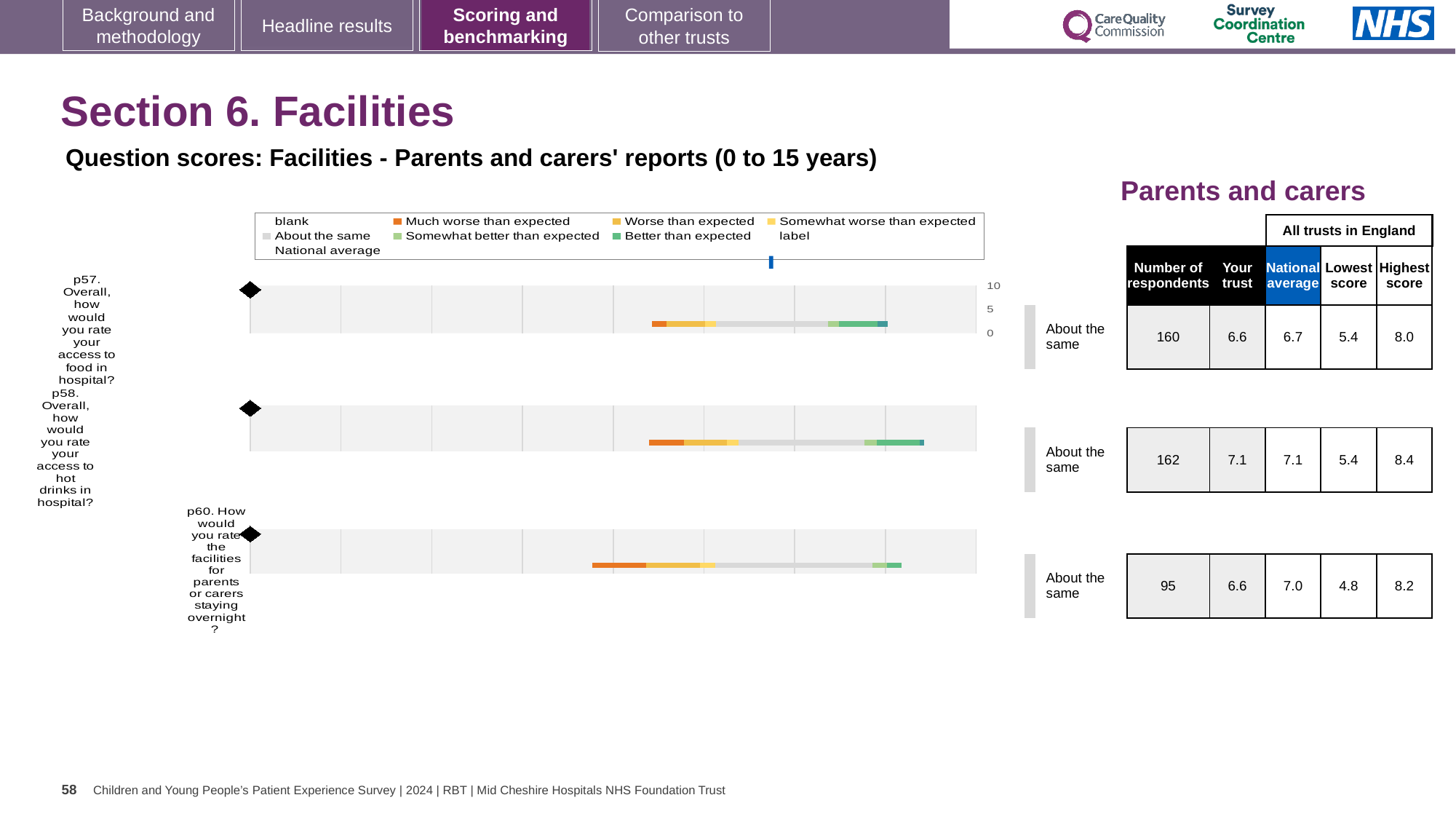
What is the highest score across all trusts in England for p58? 8.4 What kind of chart is used to show the benchmark bands for each question? bar chart Which question has the highest 'Your trust' score? p58 (access to hot drinks in hospital) What is the difference between the highest score and the lowest score for p57? 2.6 How many survey questions are plotted on this slide? 3 What is the number of respondents for p57 (access to food in hospital)? 160 What is the national average for p60 (facilities for parents or carers staying overnight)? 7.0 What is the 'Your trust' score for p58 (access to hot drinks in hospital)? 7.1 Is the 'Your trust' score for p60 higher or lower than the national average? lower What is the lowest score across all trusts in England for p60? 4.8 In the legend, what does the orange colour represent? Much worse than expected Which question has the fewest respondents? p60 (facilities for parents or carers staying overnight)